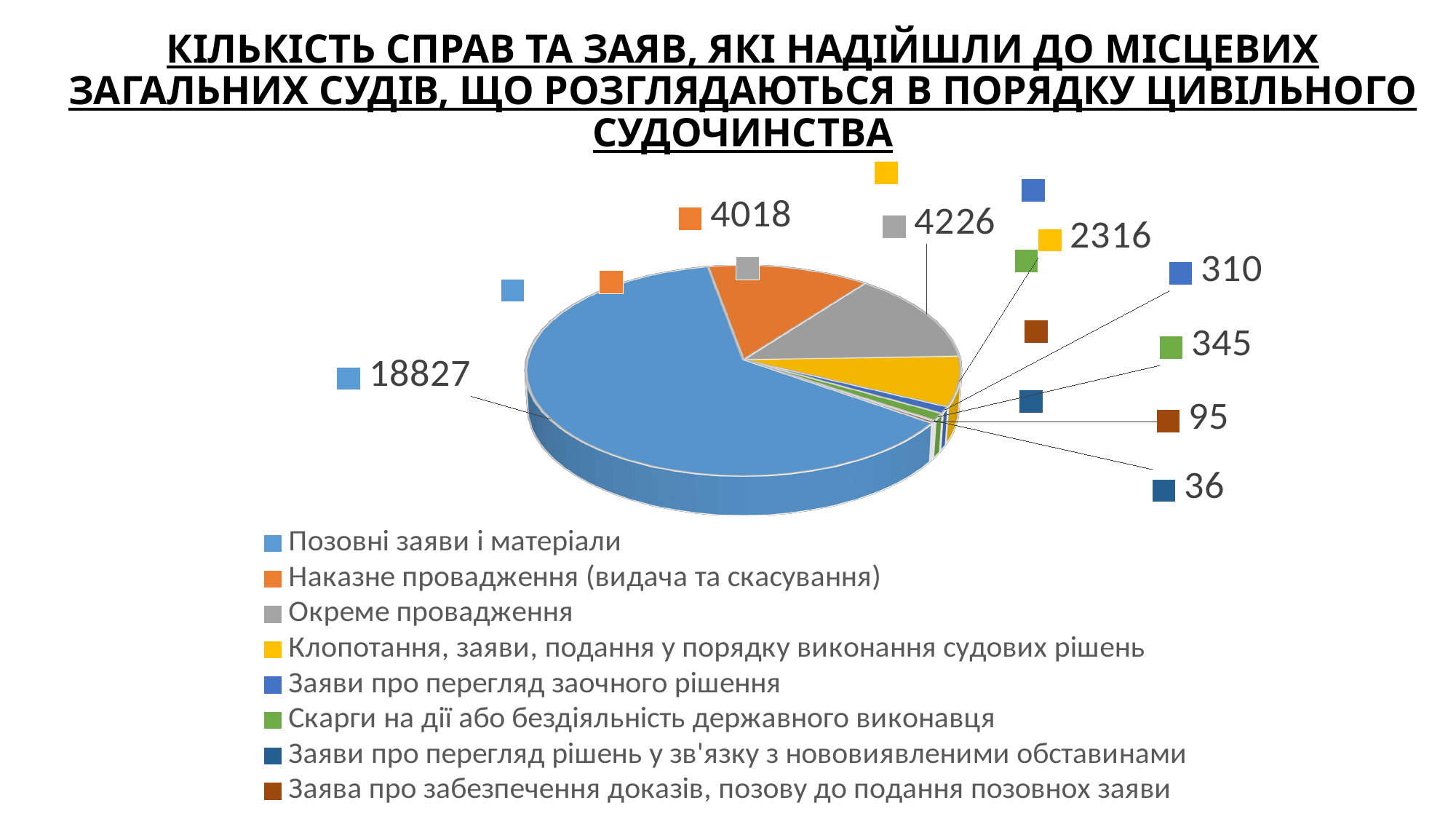
What colour is the slice for Заява про забезпечення доказів, позову до подання позовнох заяви? brown What kind of chart is shown on the slide? pie chart Which category has the smallest value? Заяви про перегляд рішень у зв'язку з нововиявленими обставинами What is the value for Заяви про перегляд рішень у зв'язку з нововиявленими обставинами? 36 What is the value for Окреме провадження? 4226 Which category has the largest slice of the pie? Позовні заяви і матеріали Which is larger: Скарги на дії або бездіяльність державного виконавця or Заяви про перегляд заочного рішення? Скарги на дії або бездіяльність державного виконавця What is the value for Наказне провадження (видача та скасування)? 4018 What is the value for Клопотання, заяви, подання у порядку виконання судових рішень? 2316 What is the difference between the values for Окреме провадження and Наказне провадження (видача та скасування)? 208 What is the value for Позовні заяви і матеріали? 18827 How many categories does the legend list? 8